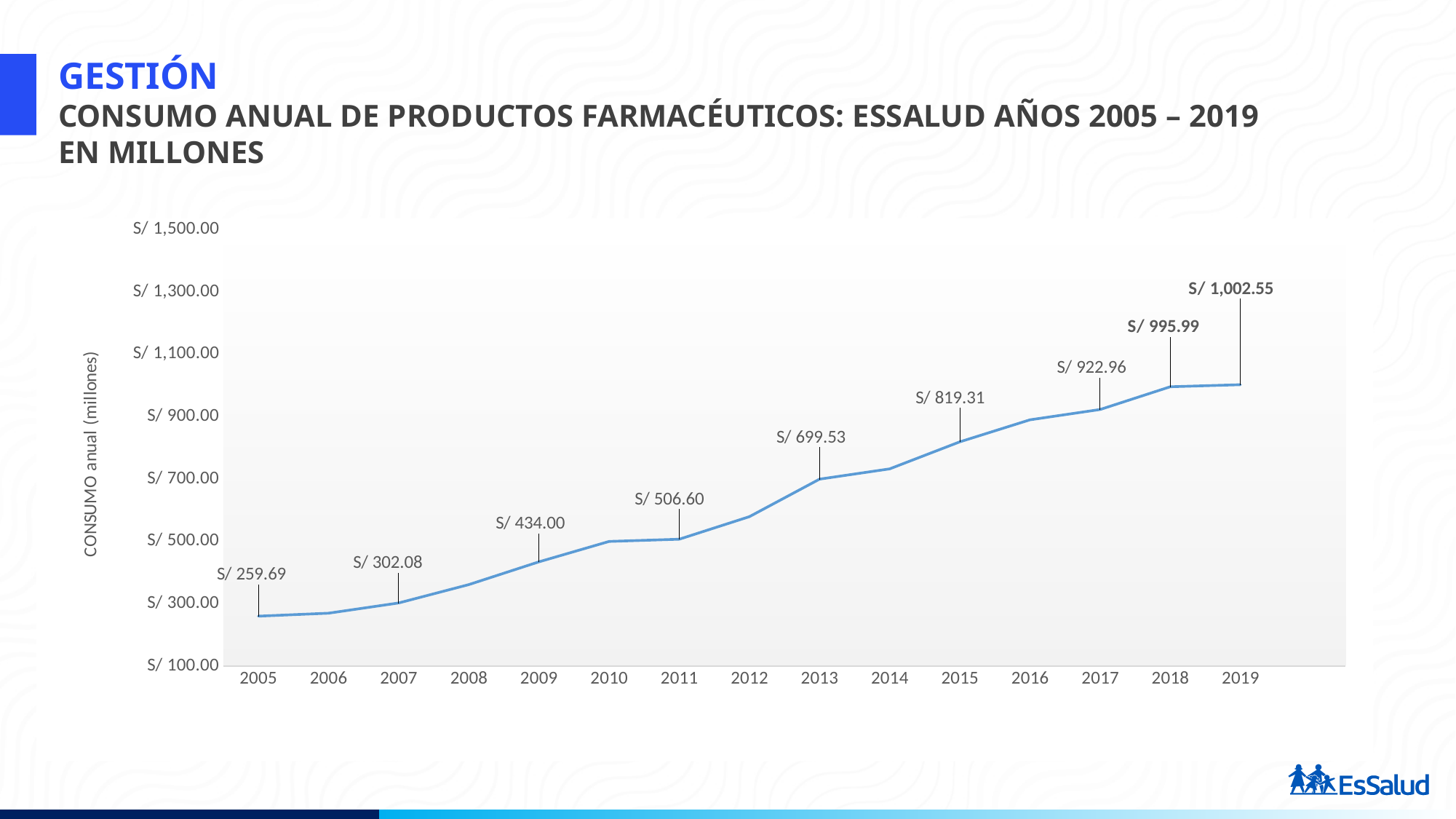
Which year has the highest annual consumption? 2019 What value is shown for 2019? S/ 1,002.55 What was the annual consumption of pharmaceutical products in 2005? S/ 259.69 What is the label of the vertical axis? CONSUMO anual (millones) What type of chart is shown on the slide? Line chart What value is shown for 2013? S/ 699.53 By how much did consumption increase from 2005 to 2019? S/ 742.86 What is the difference between the values for 2019 and 2018? S/ 6.56 Which is larger, the value for 2015 or the value for 2017? 2017 How many years are plotted on the x axis? 15 Which year has the lowest annual consumption? 2005 Is the value for 2012 greater or less than S/ 500.00? greater